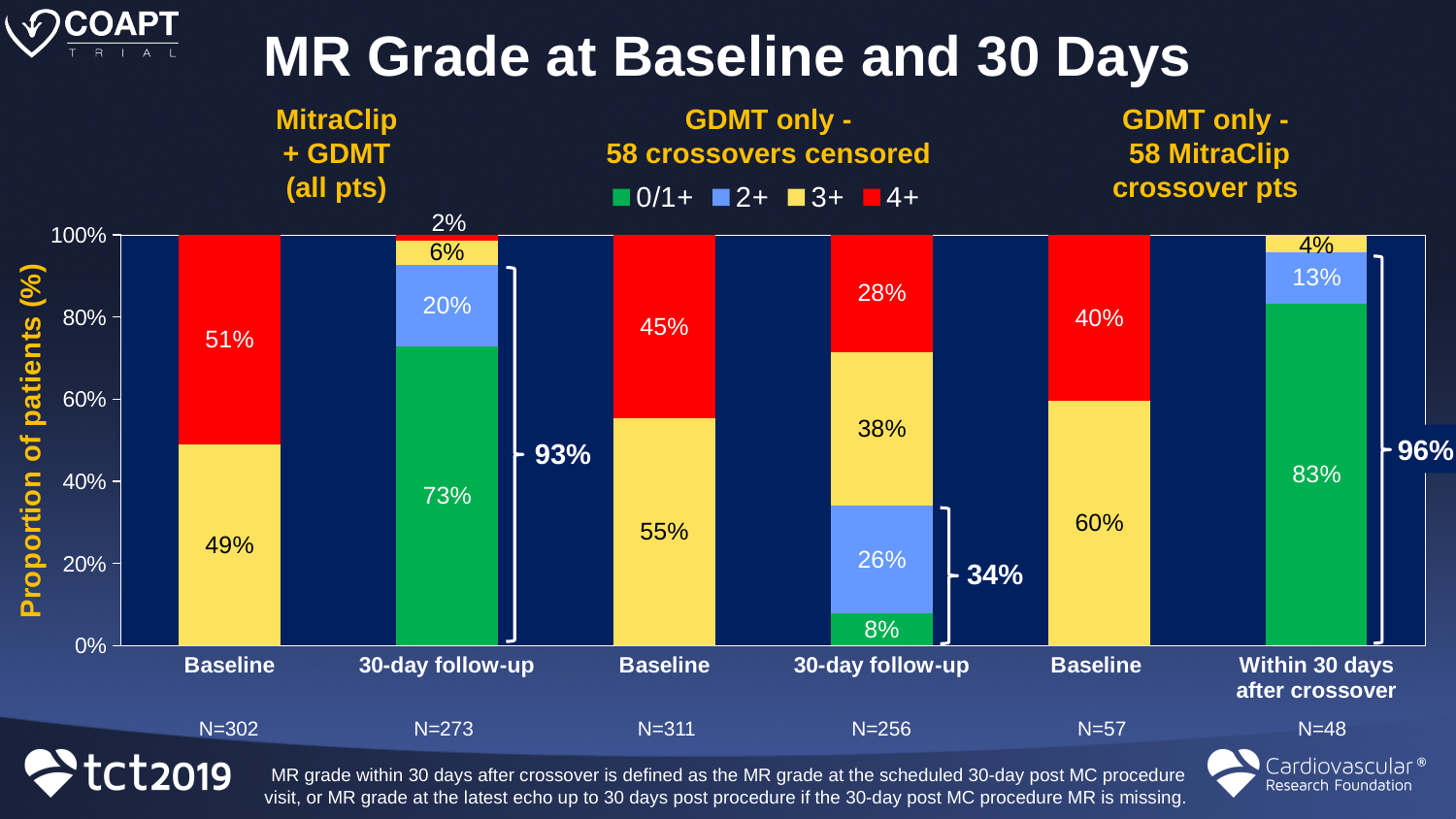
What is the difference between the 3+ share at baseline in the MitraClip + GDMT group and the 3+ share at baseline in the GDMT only (58 crossovers censored) group? 6% At 30-day follow-up, is the 2+ share larger in the MitraClip + GDMT group or in the GDMT only (58 crossovers censored) group? GDMT only (58 crossovers censored) Which bar has the smallest 0/1+ segment among the follow-up bars? 30-day follow-up (GDMT only - 58 crossovers censored) How many bars are plotted in the chart? 6 What kind of chart is shown on the slide? Stacked bar chart How many series does the legend list? 4 In the GDMT only (58 MitraClip crossover pts) group, what percentage of patients had MR grade 0/1+ within 30 days after crossover? 83% In the MitraClip + GDMT group, what percentage of patients had MR grade 0/1+ at 30-day follow-up? 73% In the GDMT only (58 crossovers censored) group, what percentage of patients had MR grade 4+ at baseline? 45% What is the combined share of 0/1+ and 2+ at 30-day follow-up in the GDMT only (58 crossovers censored) group, as shown by the bracket? 34% Which bar has the largest 0/1+ segment? Within 30 days after crossover (GDMT only - 58 MitraClip crossover pts) What is the N for the 30-day follow-up bar in the MitraClip + GDMT group? N=273